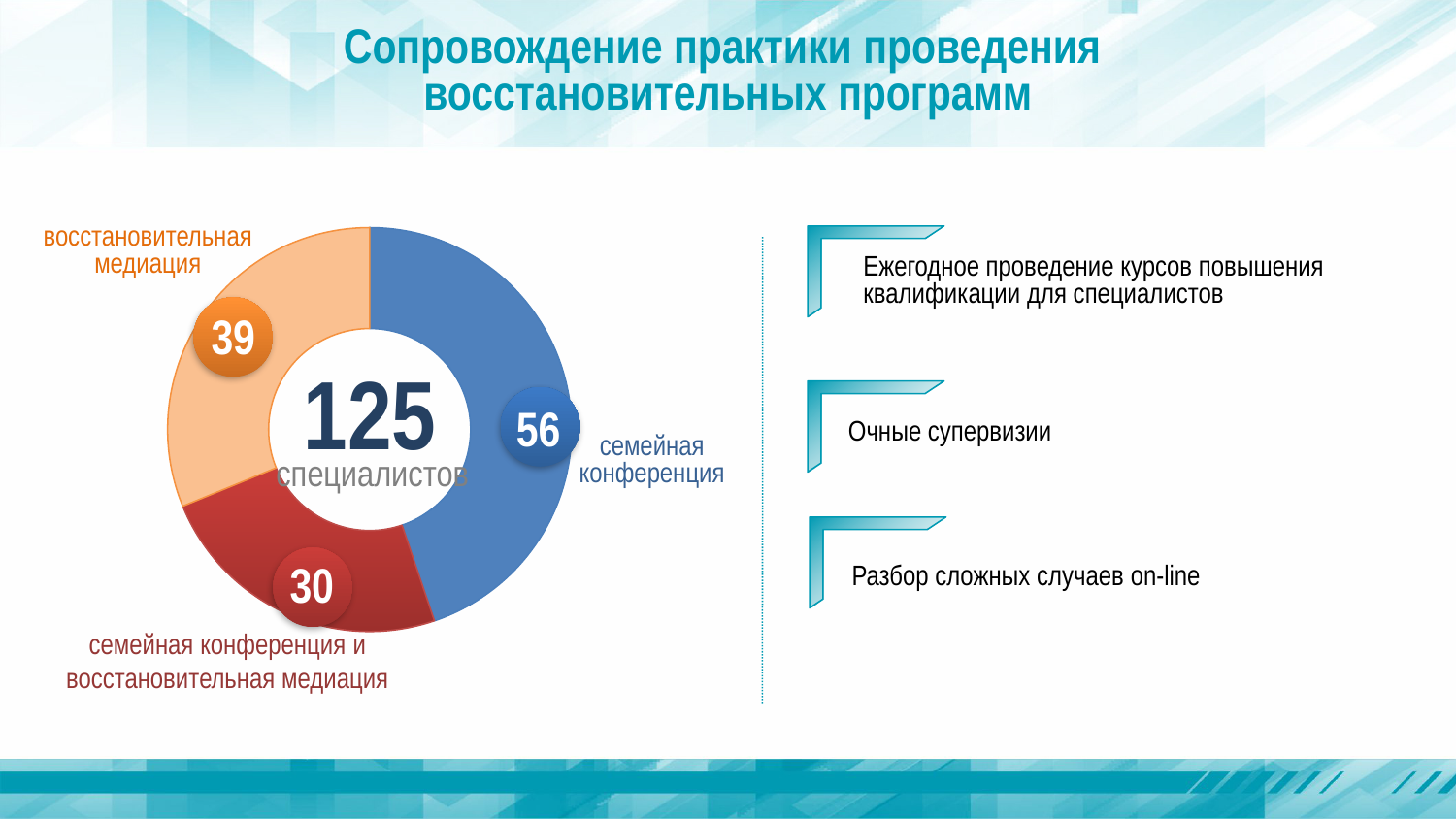
Which segment has the highest value? семейная конференция How many segments does the donut chart have? 3 What colour is the segment for семейная конференция? Blue What kind of chart is shown on the slide? Donut (pie) chart What is the value for восстановительная медиация? 39 What is the difference between the values for семейная конференция and восстановительная медиация? 17 What total number of specialists is shown in the centre of the donut chart? 125 What is the value for семейная конференция? 56 What is the value for семейная конференция и восстановительная медиация? 30 What is the title of the slide containing the chart? Сопровождение практики проведения восстановительных программ Which is larger: восстановительная медиация or семейная конференция и восстановительная медиация? восстановительная медиация Which segment has the lowest value? семейная конференция и восстановительная медиация